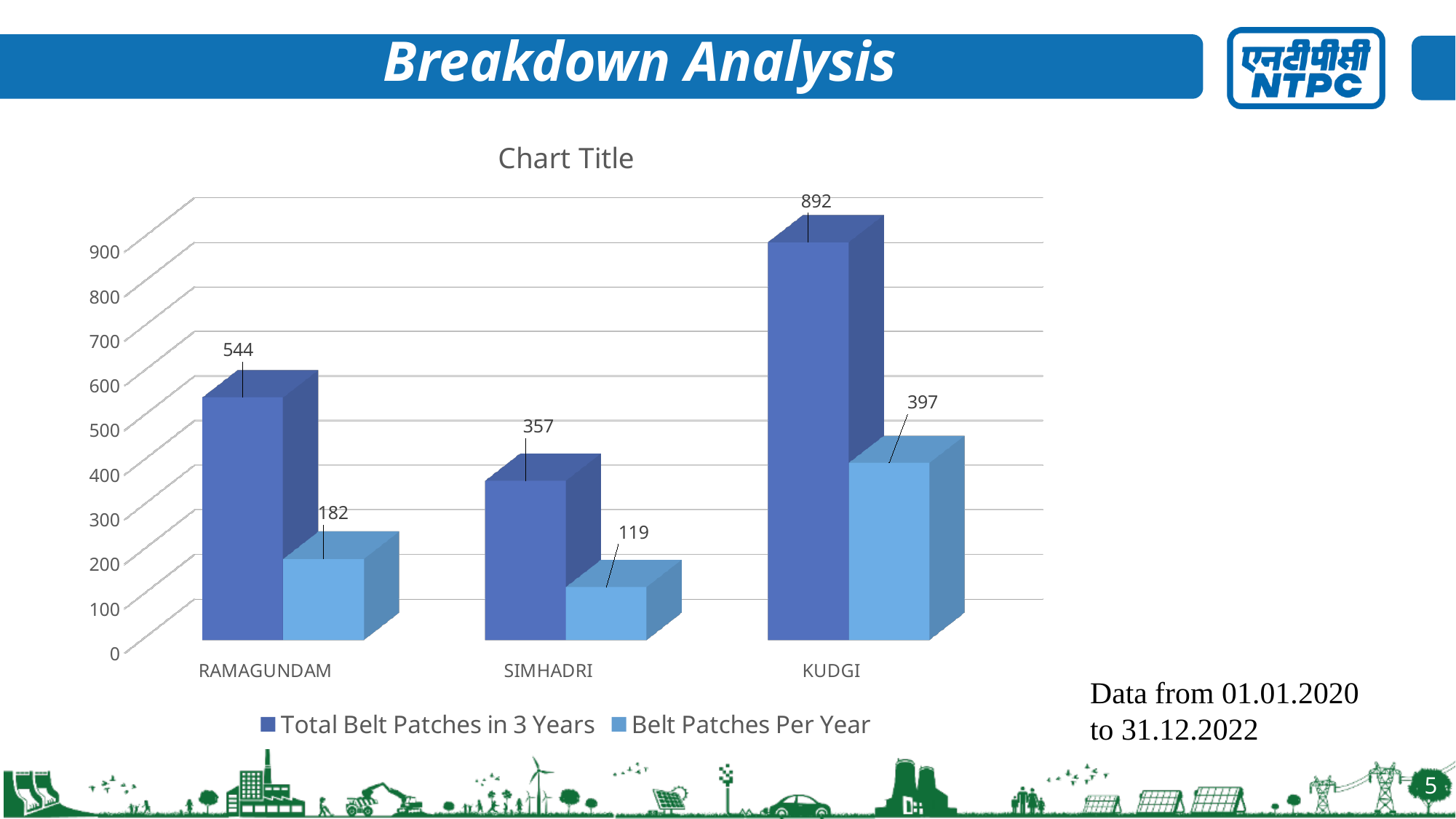
What is the title shown above the chart? Chart Title What kind of chart is shown on the slide? Bar chart What is the value of Belt Patches Per Year for SIMHADRI? 119 What is the value of Total Belt Patches in 3 Years for KUDGI? 892 Which station has the highest Total Belt Patches in 3 Years? KUDGI What is the difference between Belt Patches Per Year for KUDGI and SIMHADRI? 278 What is the difference between Total Belt Patches in 3 Years for KUDGI and RAMAGUNDAM? 348 What is the value of Belt Patches Per Year for RAMAGUNDAM? 182 How many series does the legend list? 2 How many stations are shown on the x axis? 3 Which station has the lowest Belt Patches Per Year? SIMHADRI Which is larger: Total Belt Patches in 3 Years for RAMAGUNDAM or for SIMHADRI? RAMAGUNDAM